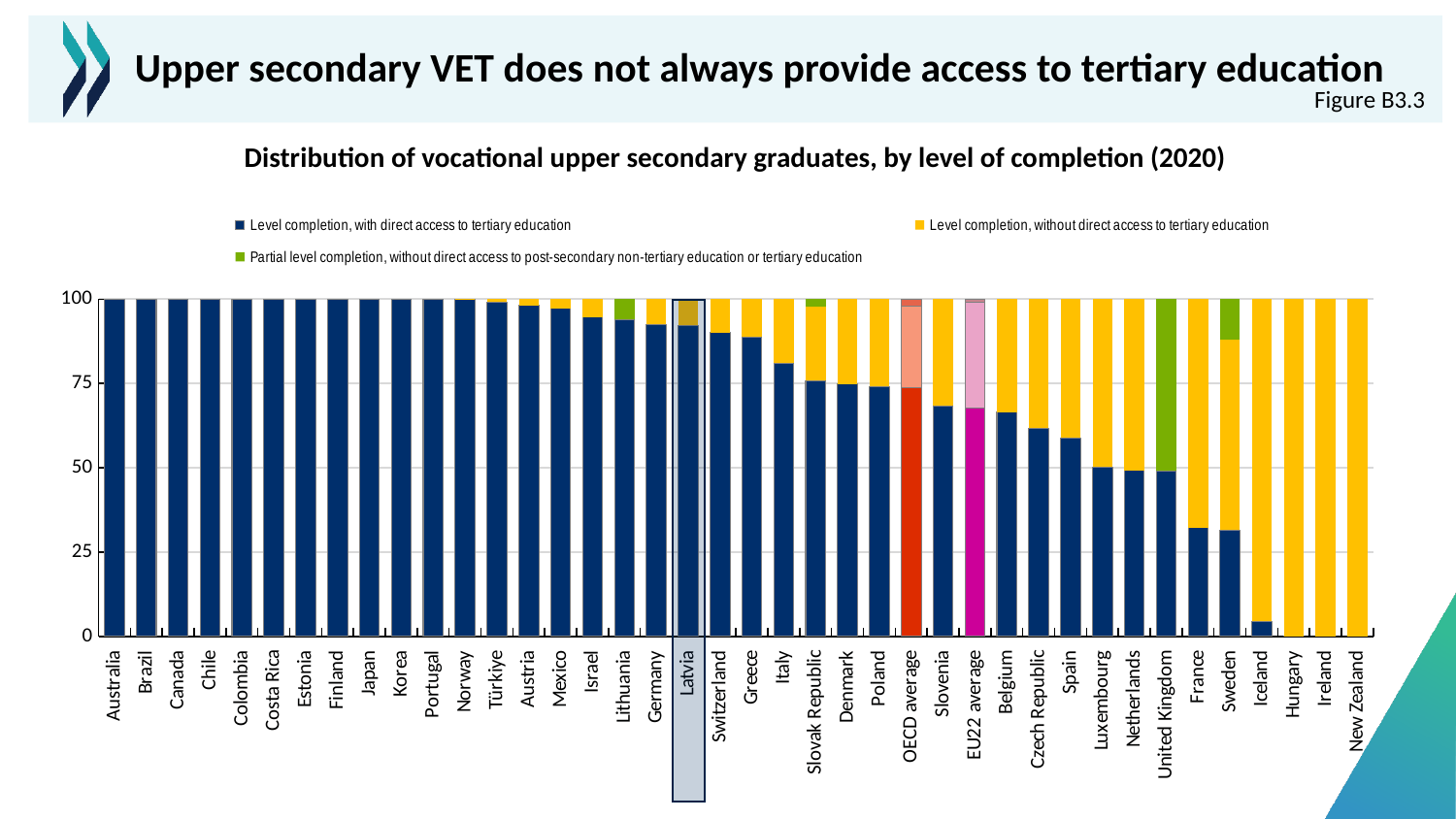
What kind of chart is shown on the slide? bar chart Do the values for 'Level completion, with direct access to tertiary education' rise or fall from left to right along the x axis? fall Is the value for Iceland in the series 'Level completion, with direct access to tertiary education' greater or less than 25? less How many countries or averages are shown along the x axis? 40 What is the title of the chart? Distribution of vocational upper secondary graduates, by level of completion (2020) How many series does the legend list? 3 Is the value for Spain in the series 'Level completion, with direct access to tertiary education' greater or less than 50? greater Which has a larger value in the series 'Level completion, with direct access to tertiary education', Sweden or Iceland? Sweden Which has a larger value in the series 'Level completion, with direct access to tertiary education', Italy or Spain? Italy Which country is highlighted with a box on the chart? Latvia Is the value for France in the series 'Level completion, with direct access to tertiary education' greater or less than 25? greater